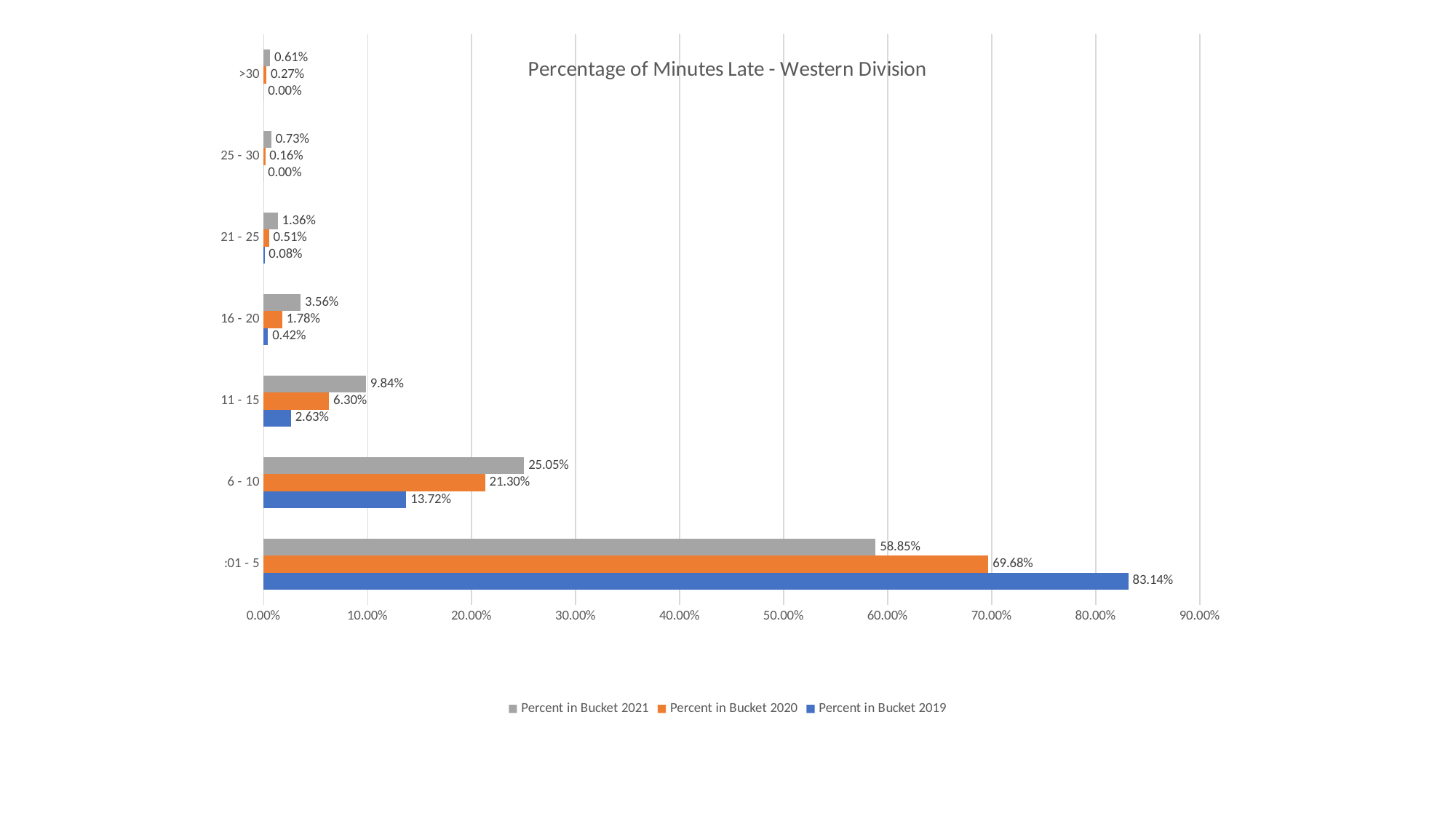
Is the value for Percent in Bucket 2020 in the ":01 - 5" category greater or less than 60.00%? greater How many series does the legend list? 3 Which category has the highest value for Percent in Bucket 2021? :01 - 5 How many categories are shown on the y axis? 7 In the "6 - 10" category, which is larger: Percent in Bucket 2020 or Percent in Bucket 2019? Percent in Bucket 2020 What is the value for Percent in Bucket 2021 in the "6 - 10" category? 25.05% What is the value for Percent in Bucket 2020 in the "11 - 15" category? 6.30% What is the title of the chart? Percentage of Minutes Late - Western Division What kind of chart is shown on the slide? Bar chart What is the difference between Percent in Bucket 2019 and Percent in Bucket 2021 in the ":01 - 5" category? 24.29% What is the value for Percent in Bucket 2019 in the ":01 - 5" category? 83.14% Which category has the lowest value for Percent in Bucket 2020? 25 - 30